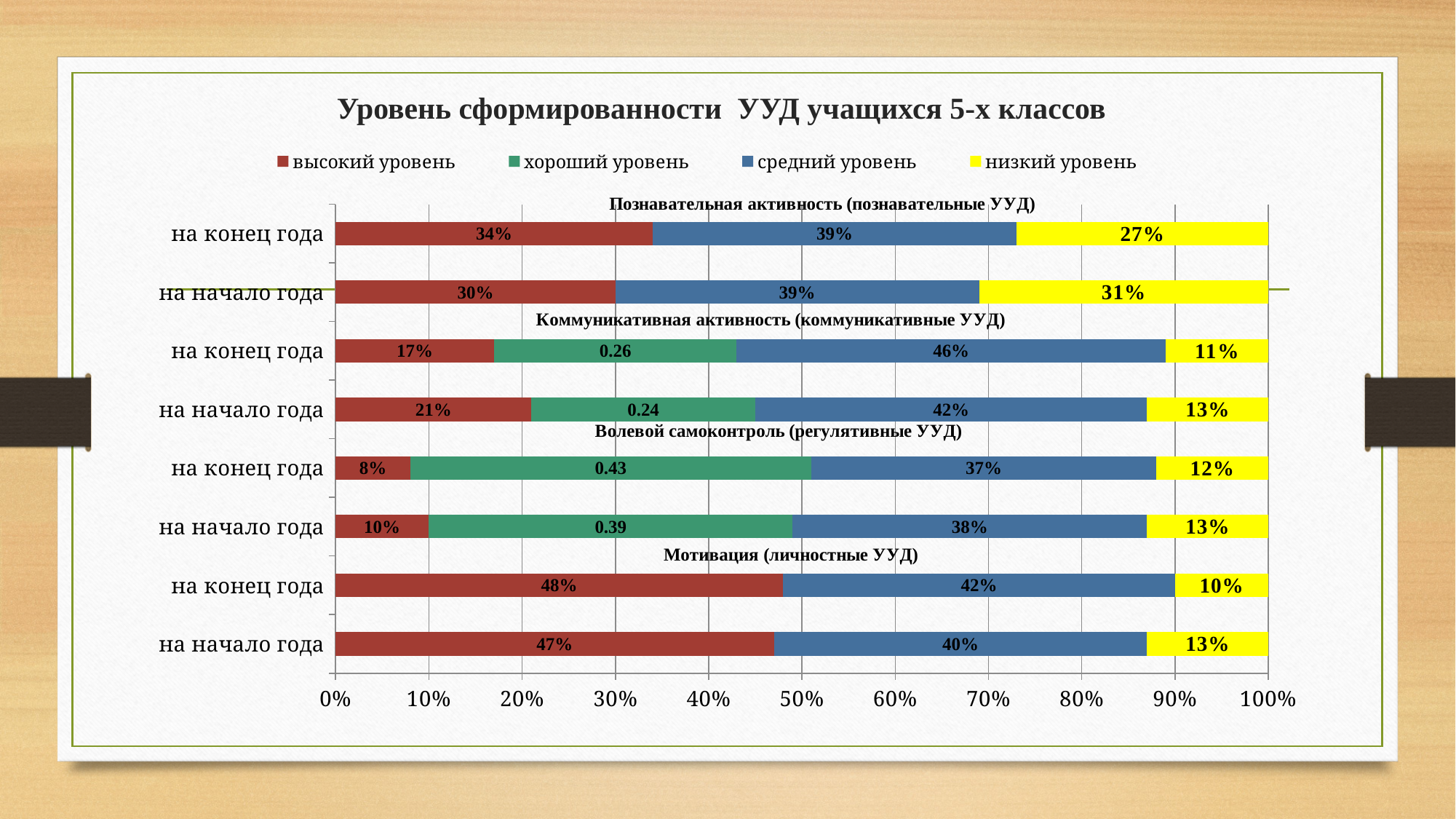
What is the value of 'высокий уровень' for 'на конец года' in the 'Мотивация (личностные УУД)' group? 48% What is the value of 'низкий уровень' for 'на начало года' in the 'Познавательная активность (познавательные УУД)' group? 31% How many series does the legend list? 4 In the 'Волевой самоконтроль (регулятивные УУД)' group, which is larger for 'высокий уровень': 'на начало года' or 'на конец года'? на начало года What is the value of 'высокий уровень' for 'на конец года' in the 'Познавательная активность (познавательные УУД)' group? 34% What is the value of 'хороший уровень' for 'на конец года' in the 'Коммуникативная активность (коммуникативные УУД)' group? 0.26 Which colour represents 'низкий уровень' in the chart? yellow What kind of chart is shown on the slide? stacked bar chart How many bars are plotted in the chart? 8 What is the value of 'средний уровень' for 'на начало года' in the 'Волевой самоконтроль (регулятивные УУД)' group? 38% Which bar has the highest 'высокий уровень' value? Мотивация (личностные УУД), на конец года In the 'Мотивация (личностные УУД)' group, what is the difference in 'низкий уровень' between 'на начало года' and 'на конец года'? 3%